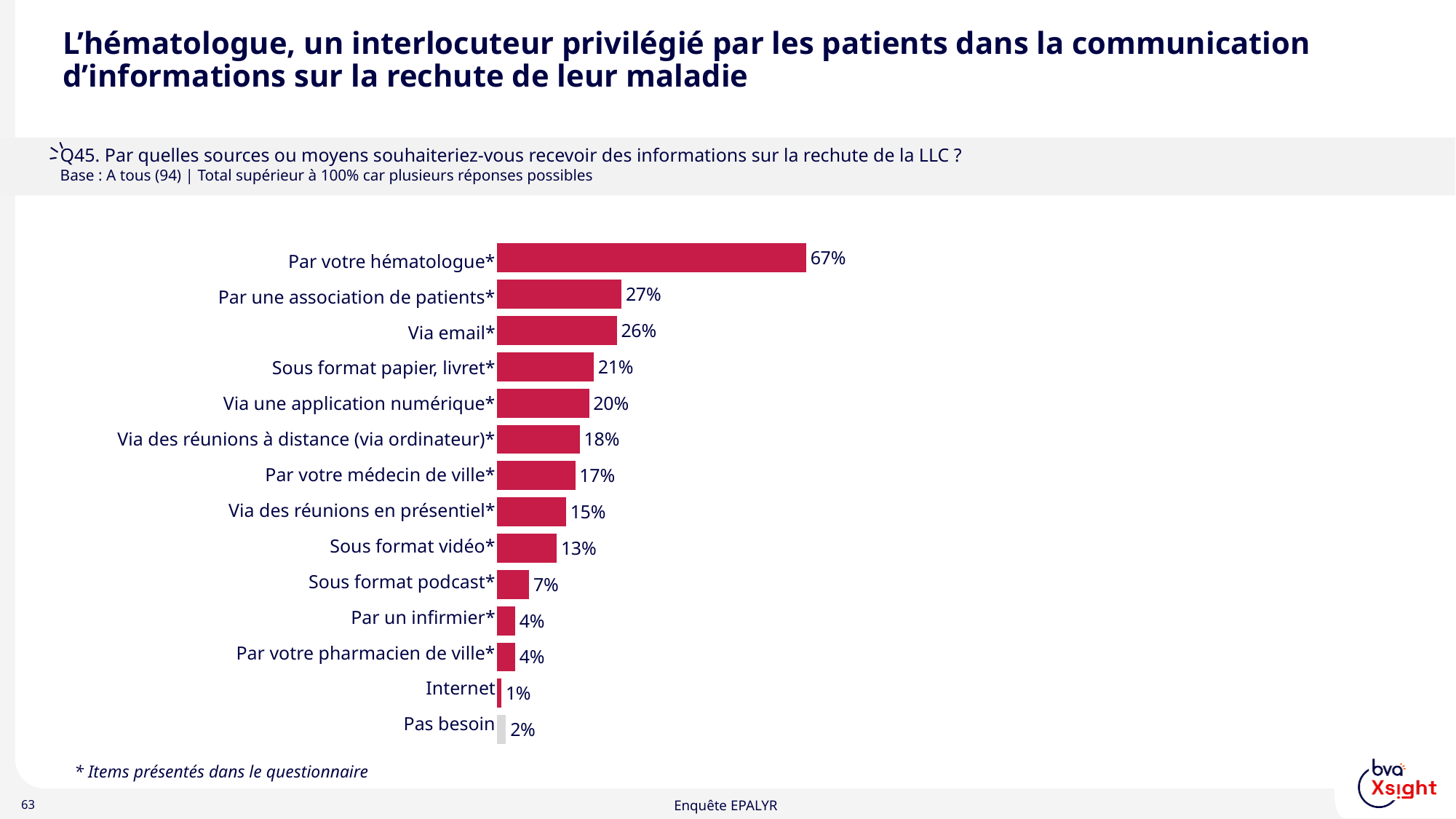
Which is larger: 'Par votre médecin de ville*' or 'Via des réunions en présentiel*'? Par votre médecin de ville* Which category has the highest value? Par votre hématologue* Which category has the lowest value? Internet What is the value for 'Sous format podcast*'? 7% What is the difference between 'Sous format papier, livret*' and 'Sous format vidéo*'? 8% What is the value for 'Via email*'? 26% What is the difference between 'Par votre hématologue*' and 'Par une association de patients*'? 40% How many categories are shown in the chart? 14 What percentage of respondents want to receive information via their hematologist (Par votre hématologue*)? 67% Which category's bar is shown in grey rather than red? Pas besoin What kind of chart is shown on the slide? Bar chart What is the value for 'Pas besoin'? 2%